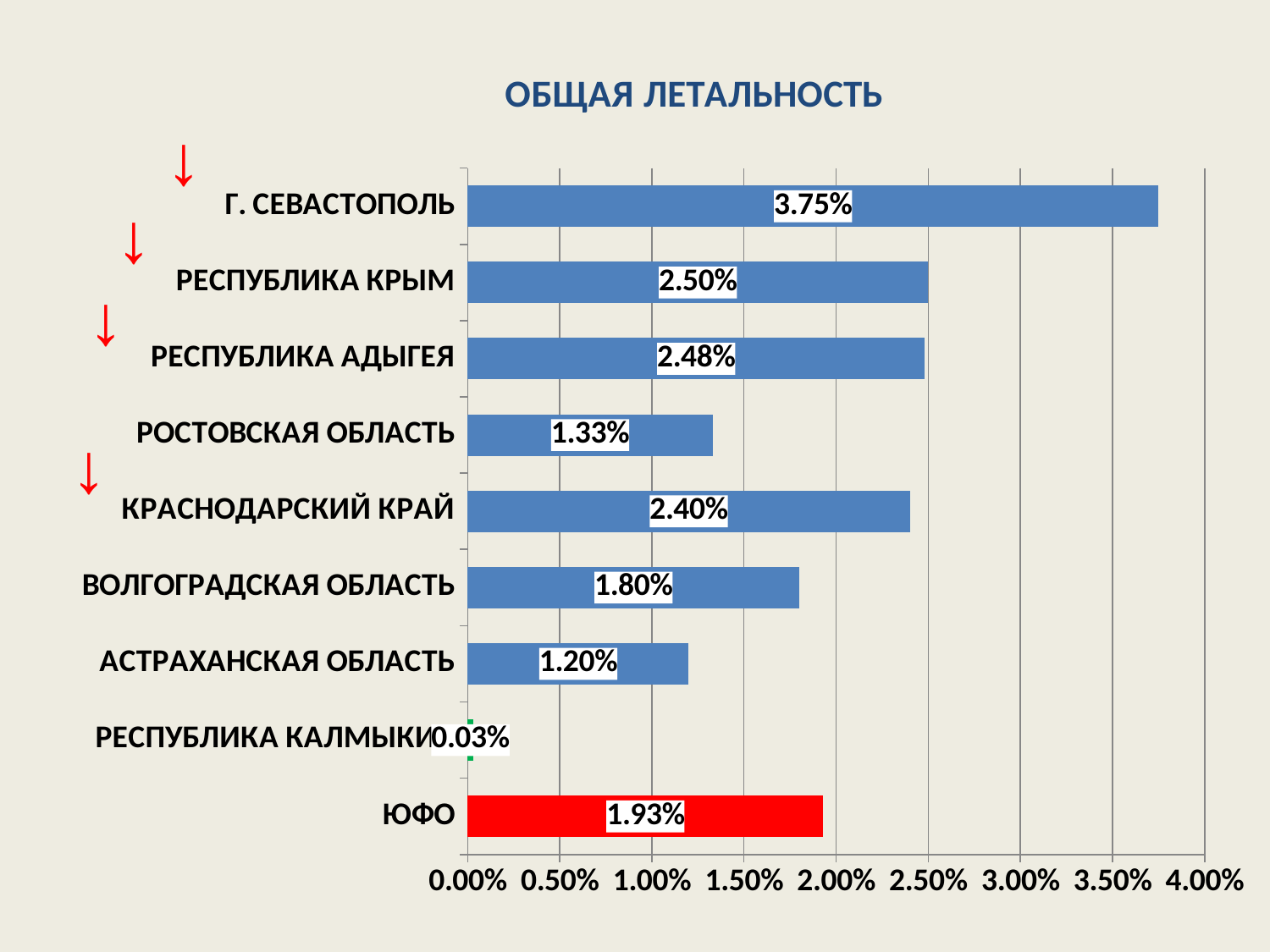
What is the value for ЮФО? 1.93% How many categories are shown in the chart? 9 What is the title of the chart? ОБЩАЯ ЛЕТАЛЬНОСТЬ Which category has the highest value? Г. СЕВАСТОПОЛЬ Is the value for АСТРАХАНСКАЯ ОБЛАСТЬ greater or less than 1.50%? less Which bar is coloured red? ЮФО Which category has the lowest value? РЕСПУБЛИКА КАЛМЫКИЯ What is the value for Г. СЕВАСТОПОЛЬ? 3.75% Which is larger, the value for КРАСНОДАРСКИЙ КРАЙ or the value for ВОЛГОГРАДСКАЯ ОБЛАСТЬ? КРАСНОДАРСКИЙ КРАЙ What kind of chart is shown on the slide? bar chart What is the difference between the values for Г. СЕВАСТОПОЛЬ and РЕСПУБЛИКА КРЫМ? 1.25% What is the value for РОСТОВСКАЯ ОБЛАСТЬ? 1.33%